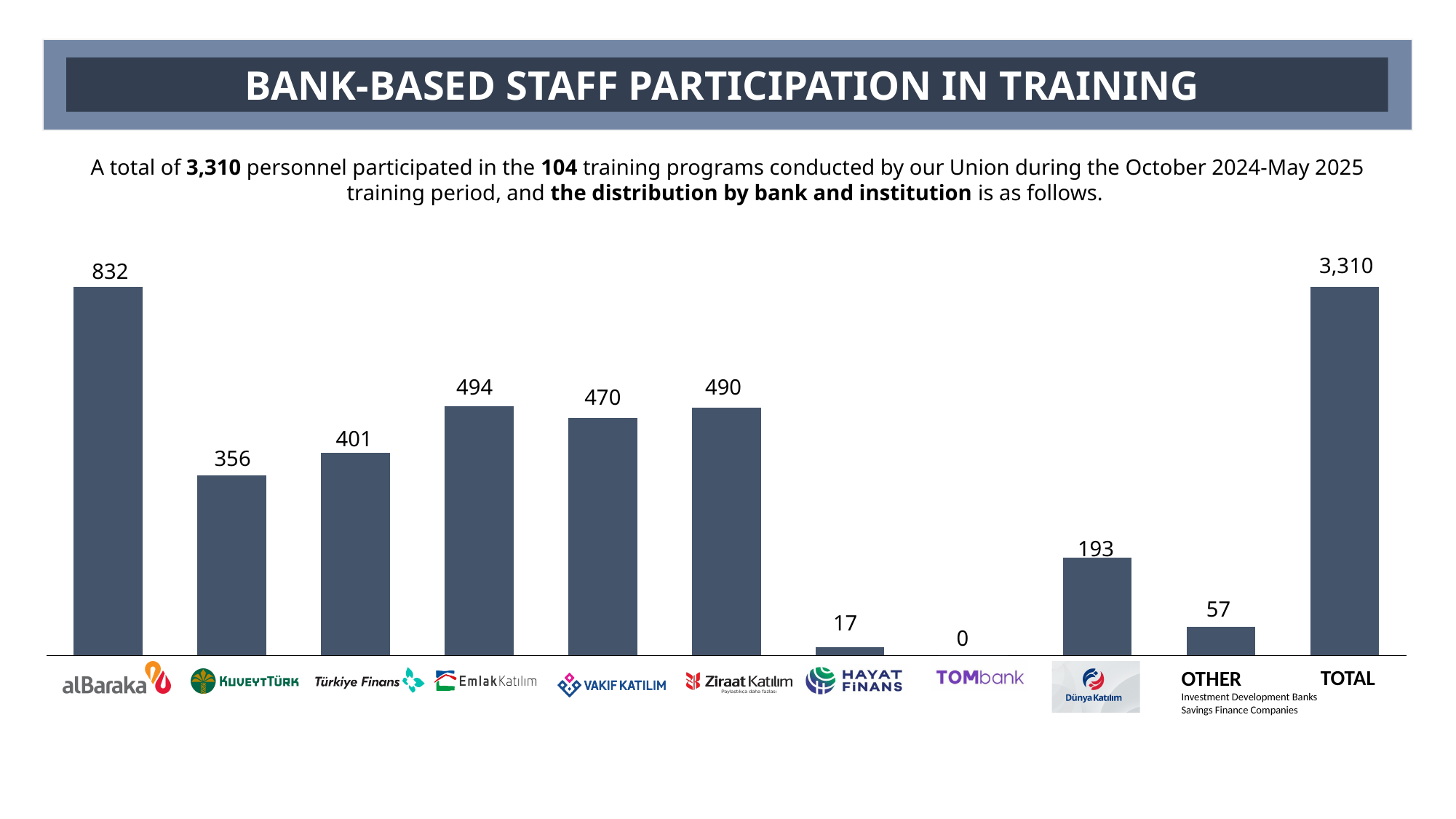
Excluding the TOTAL bar, which bank has the highest value? Albaraka What is the title of the slide? BANK-BASED STAFF PARTICIPATION IN TRAINING What kind of chart is shown on the slide? Bar chart How many bars are shown in the chart, including the TOTAL bar? 11 Which is larger, the value for Türkiye Finans or the value for Vakıf Katılım? Vakıf Katılım What is the value for Kuveyt Türk? 356 What is the value for Albaraka? 832 What is the difference between the values for Albaraka and Kuveyt Türk? 476 Which category has the lowest value? TOMbank What is the value for Emlak Katılım? 494 What is the value for TOMbank? 0 What is the value shown for the TOTAL bar? 3,310